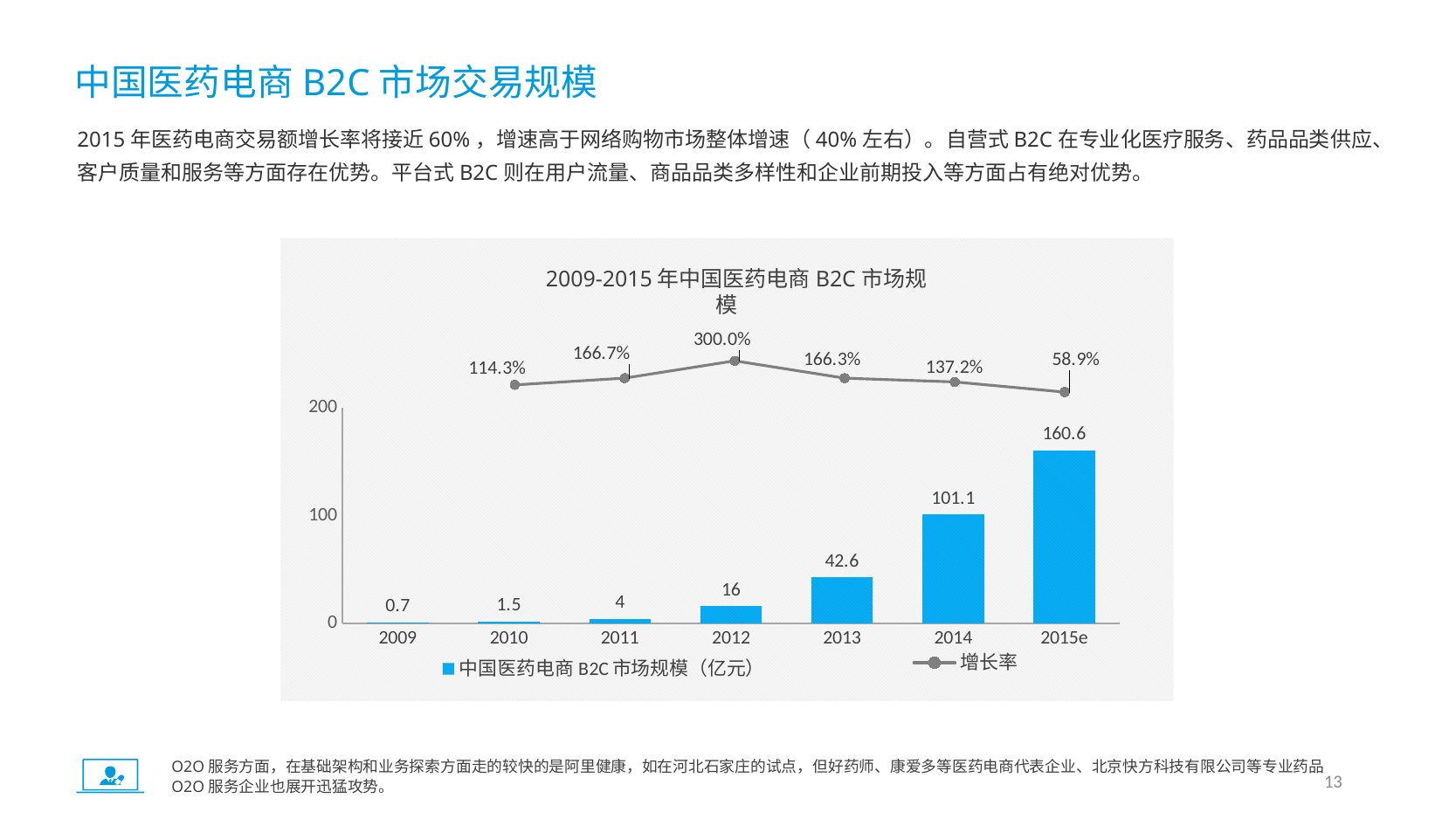
What is the market size (中国医药电商 B2C 市场规模) for 2014? 101.1 Which is larger, the growth rate for 2011 or the growth rate for 2013? 2011 What is the difference in market size between 2015e and 2014? 59.5 What is the growth rate (增长率) for 2012? 300.0% How many years are shown on the x axis? 7 What is the market size value for 2015e? 160.6 Which year has the lowest market size? 2009 Which year has the highest growth rate (增长率)? 2012 Is the market size for 2013 greater or less than 100? less What kind of chart is used for the market size series? bar chart How many series does the legend list? 2 Does the market size rise or fall from 2009 to 2015e? rise